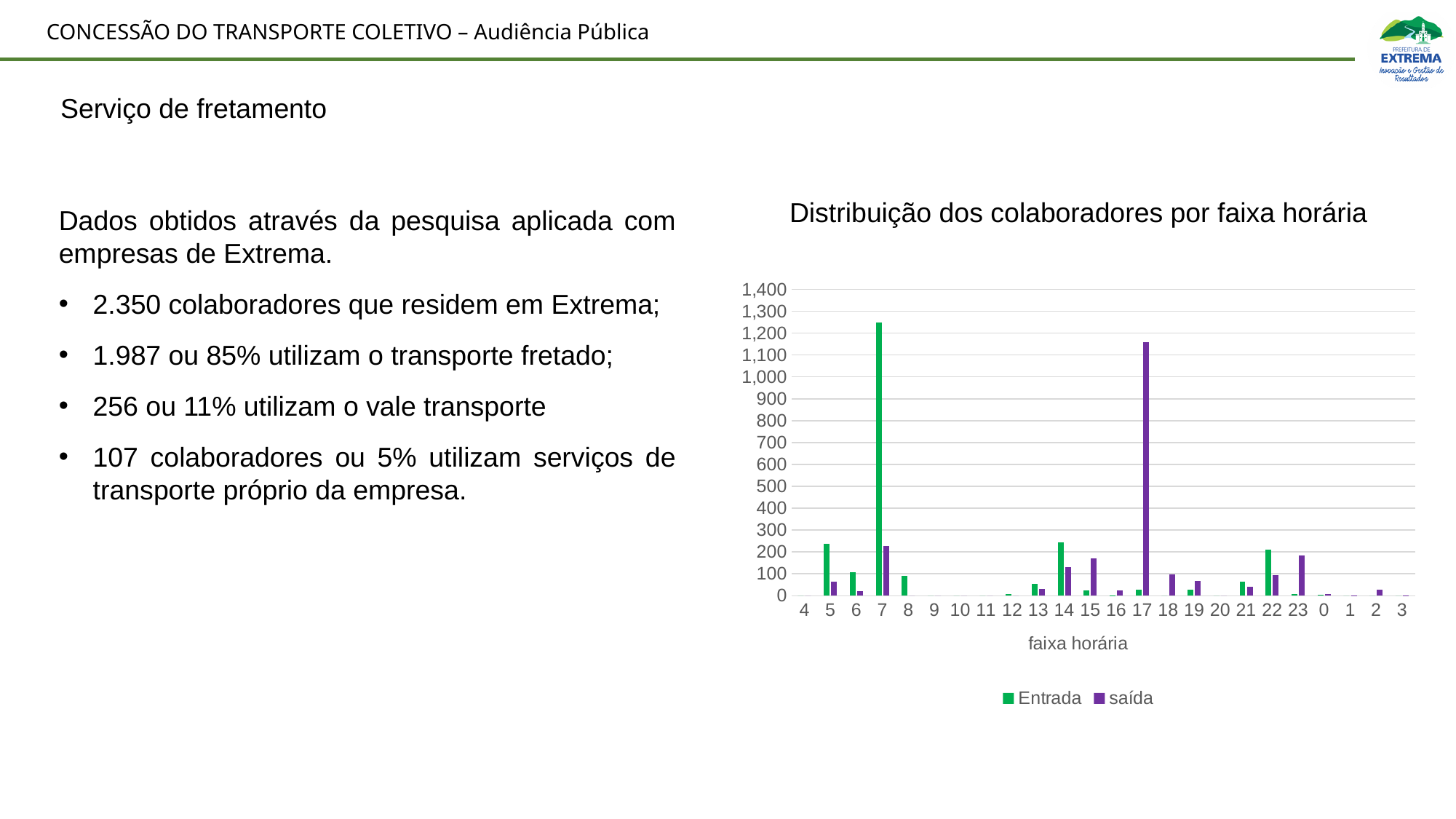
Which faixa horária has the highest saída value? 17 What is the label of the x axis of the chart? faixa horária At faixa horária 7, which series has the larger value, Entrada or saída? Entrada Is the Entrada value for faixa horária 7 greater or less than 1,000? greater Is the Entrada value for faixa horária 5 greater or less than 200? greater What is the title of the chart? Distribuição dos colaboradores por faixa horária How many series does the legend of the chart list? 2 Is the saída value for faixa horária 17 greater or less than 1,000? greater Which faixa horária has the highest Entrada value? 7 How many time-slot categories are shown on the x axis of the chart? 24 What kind of chart is shown on the slide? bar chart At faixa horária 23, which series has the larger value, Entrada or saída? saída